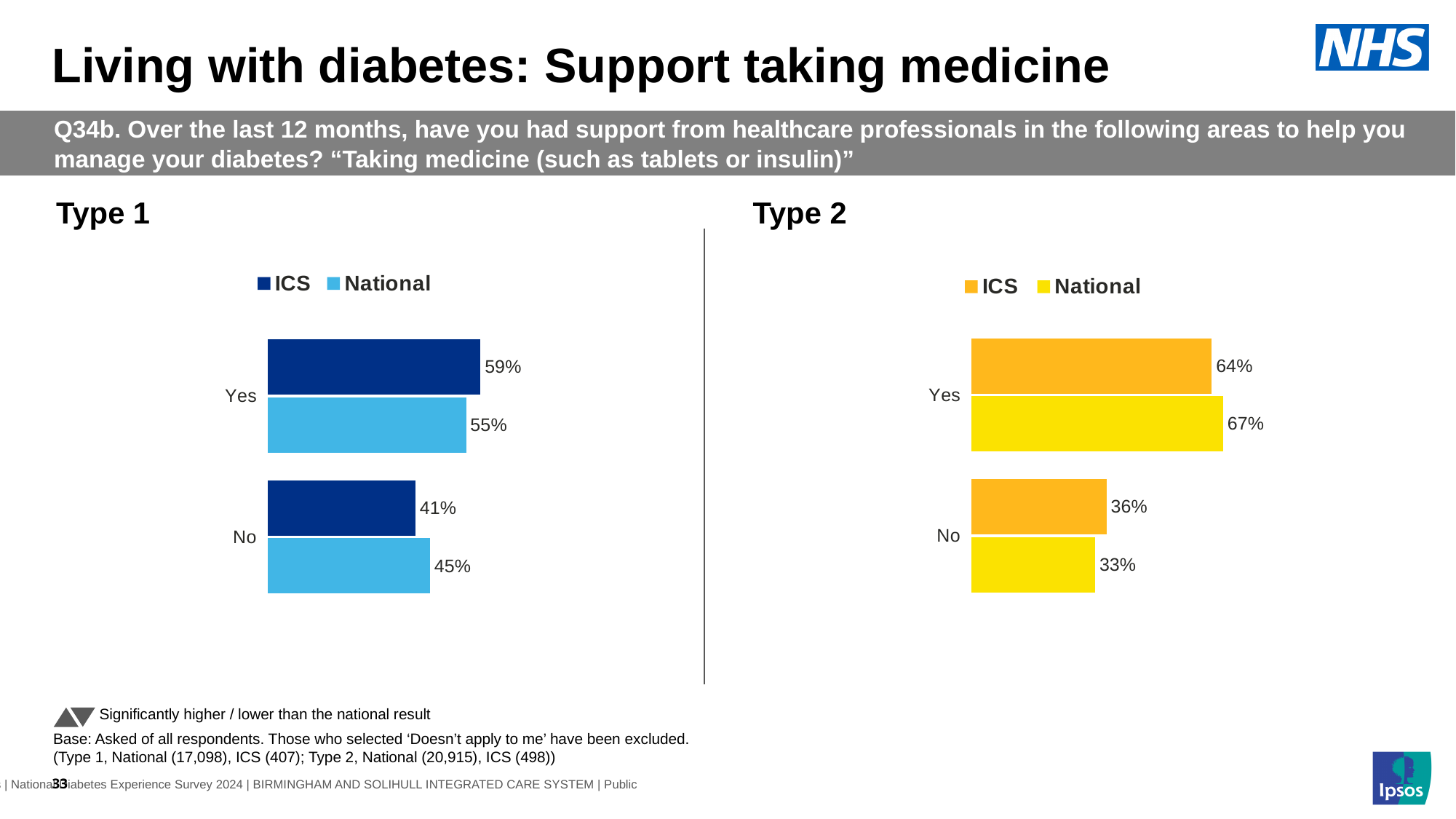
In the Type 1 chart, what is the difference between the ICS and National values for Yes? 4 percentage points In the Type 2 chart, which is larger for Yes: ICS or National? National In the Type 1 chart, how many response categories are shown? 2 In the Type 1 chart, what is the National value for No? 45% In the Type 2 chart, what is the difference between the National and ICS values for No? 3 percentage points What kind of chart is the Type 2 chart? Bar chart In the Type 1 chart, how many series does the legend list? 2 In the Type 2 chart, what is the National value for Yes? 67% In the Type 2 chart, what is the ICS value for No? 36% In the Type 1 chart, which is larger for No: ICS or National? National In the Type 1 chart, what is the ICS value for Yes? 59% In the Type 2 chart, which series has the highest value shown? National (67%)